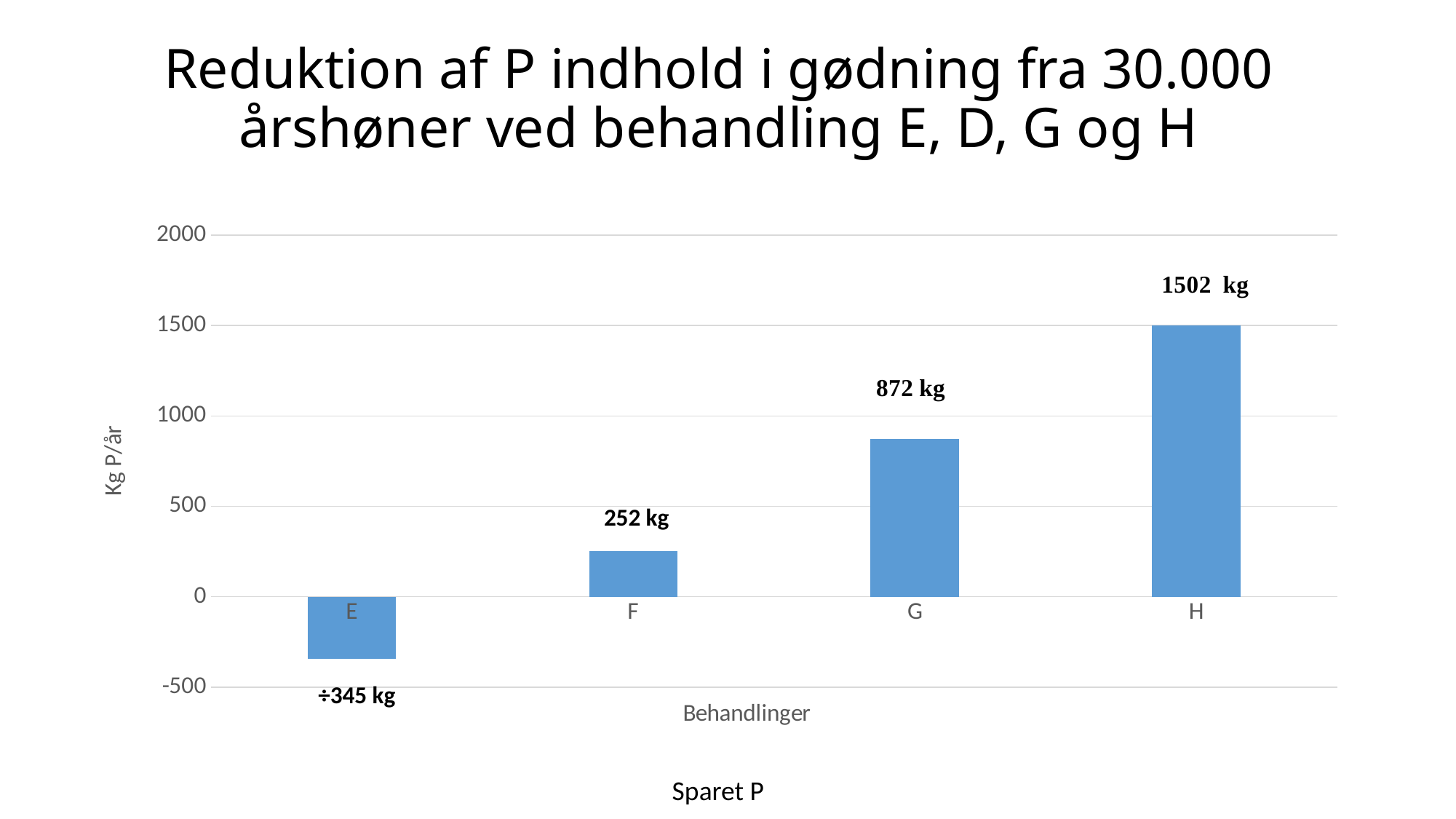
What is the difference between the values for H and G? 630 kg What is the value for treatment H? 1502 kg Which is larger, the value for F or the value for G? G What is the value for treatment G? 872 kg Is the value for H greater or less than 1000? greater What is the difference between the values for G and F? 620 kg What kind of chart is this? bar chart What is the data label shown for treatment E? ÷345 kg Which treatment has the lowest value? E Which treatment has the highest value? H How many treatments are shown on the x axis? 4 What is the value for treatment F? 252 kg